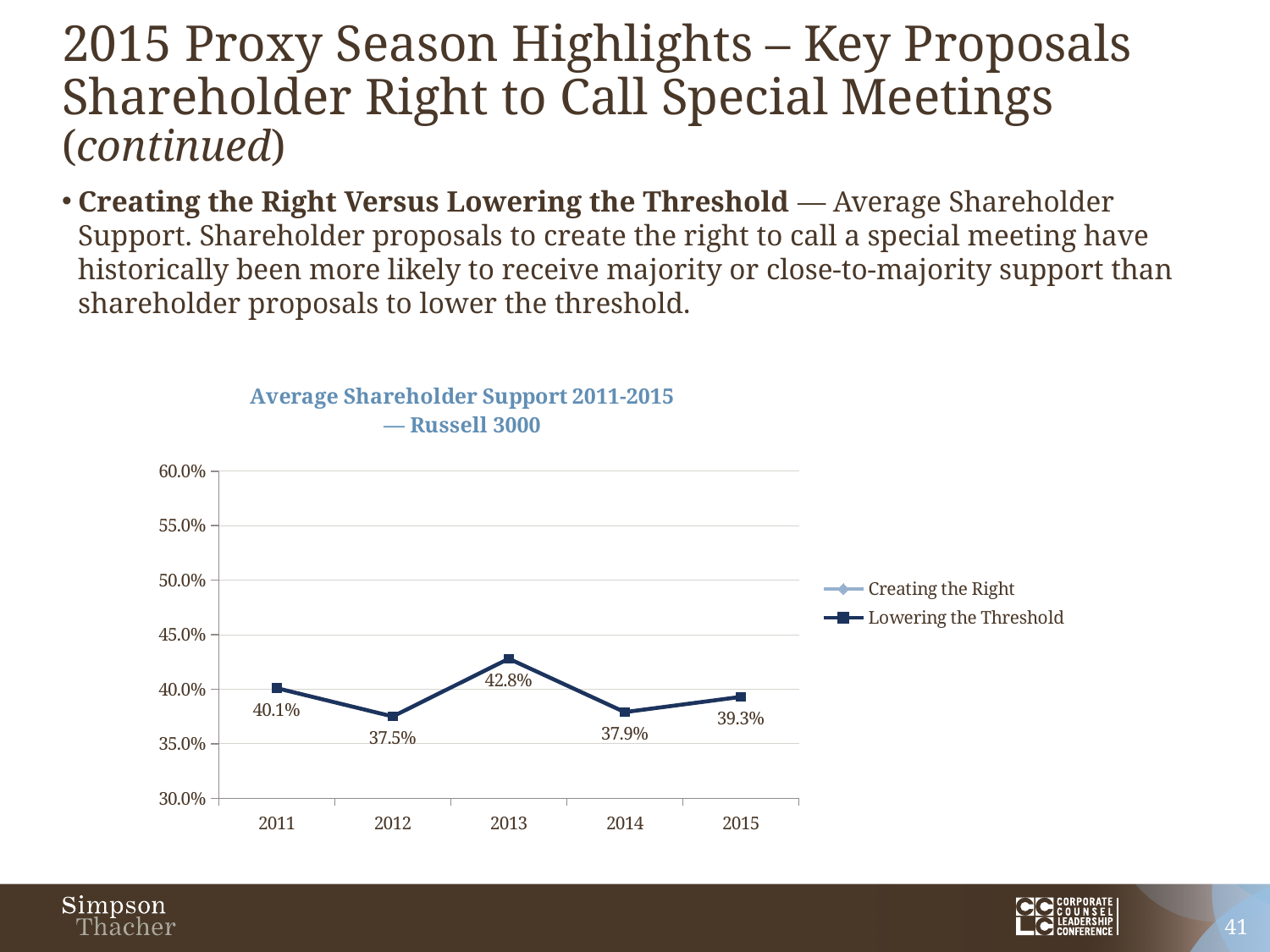
Which year has a larger Lowering the Threshold value, 2011 or 2014? 2011 What is the value for Lowering the Threshold in 2011? 40.1% Is the Lowering the Threshold value for 2013 greater or less than 45.0%? less In which year is the Lowering the Threshold value highest? 2013 In which year is the Lowering the Threshold value lowest? 2012 What is the value for Lowering the Threshold in 2013? 42.8% What is the title of the chart? Average Shareholder Support 2011-2015 — Russell 3000 What is the difference between the Lowering the Threshold values for 2013 and 2012? 5.3% How many series does the legend list? 2 What kind of chart is shown on the slide? line chart How many years are shown on the x axis? 5 What is the value for Lowering the Threshold in 2015? 39.3%